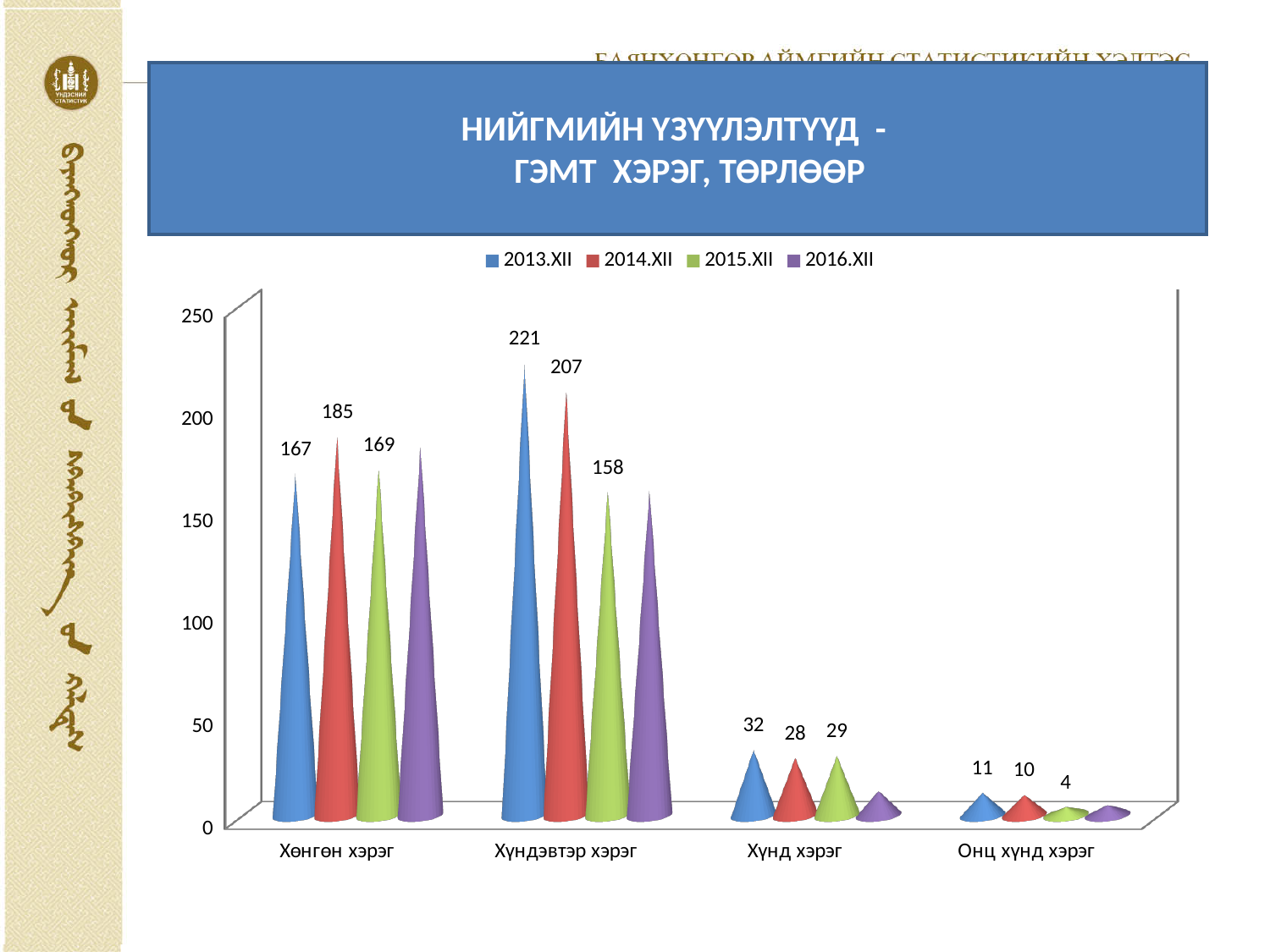
Is the 2016.XII value for Хөнгөн хэрэг greater or less than 150? greater Which category has the highest value in the 2013.XII series? Хүндэвтэр хэрэг Which is larger for Хөнгөн хэрэг: the 2014.XII value or the 2013.XII value? 2014.XII How many series does the legend list? 4 What is the value for Хүндэвтэр хэрэг in the 2013.XII series? 221 Is the 2016.XII value for Хүнд хэрэг greater or less than 50? less How many categories are shown on the x axis? 4 What is the value for Онц хүнд хэрэг in the 2015.XII series? 4 What is the value for Хөнгөн хэрэг in the 2014.XII series? 185 Which category has the lowest value in the 2014.XII series? Онц хүнд хэрэг What kind of chart is shown on the slide? bar chart What is the difference between the 2013.XII and 2015.XII values for Хүндэвтэр хэрэг? 63